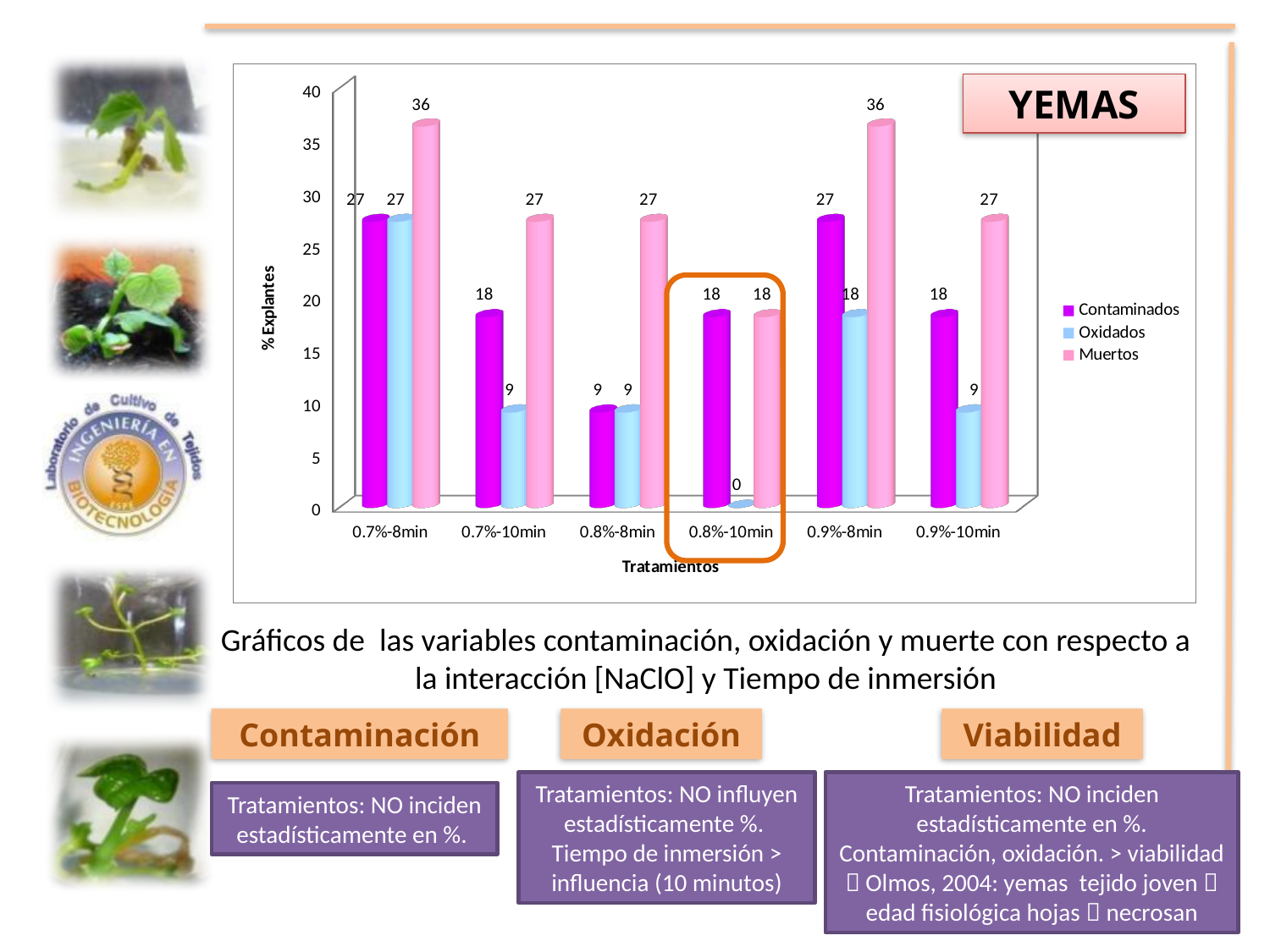
Which is larger for the 0.9%-8min treatment, Contaminados or Oxidados? Contaminados What is the value of Contaminados for the 0.8%-8min treatment? 9 Which treatment is highlighted with an orange box on the chart? 0.8%-10min Which treatment has the lowest Oxidados value? 0.8%-10min What is the value of Oxidados for the 0.8%-10min treatment? 0 What is the value of Muertos for the 0.7%-8min treatment? 36 How many series does the legend list? 3 What is the label of the y axis? % Explantes What is the difference between Muertos and Contaminados for the 0.7%-10min treatment? 9 What is the value of Oxidados for the 0.9%-8min treatment? 18 How many treatment categories are shown on the x axis? 6 What kind of chart is shown on the slide? bar chart